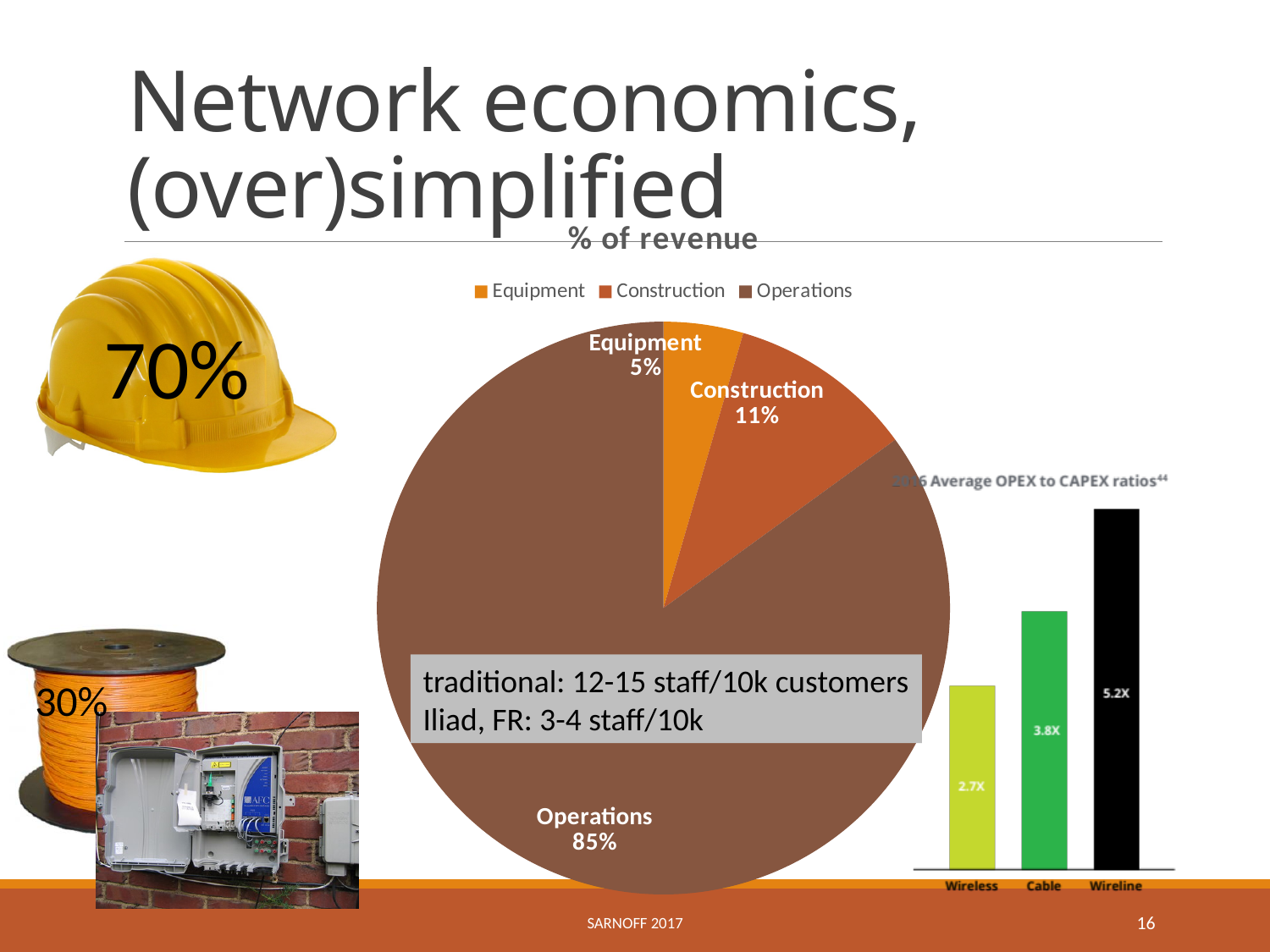
In the '% of revenue' pie chart, which category has the largest slice? Operations In the '% of revenue' pie chart, what share does Operations have? 85% In the '% of revenue' pie chart, which category has the smallest slice? Equipment In the 'Average OPEX to CAPEX ratios' bar chart, what is the value for Wireline? 5.2X In the 'Average OPEX to CAPEX ratios' bar chart, which category has the lowest value? Wireless How many series does the legend of the '% of revenue' pie chart list? 3 In the '% of revenue' pie chart, what share does Equipment have? 5% What kind of chart is the '% of revenue' chart? pie chart In the 'Average OPEX to CAPEX ratios' bar chart, what is the value for Cable? 3.8X In the '% of revenue' pie chart, how many slices are there? 3 What kind of chart is the 'Average OPEX to CAPEX ratios' chart? bar chart In the '% of revenue' pie chart, what share does Construction have? 11%